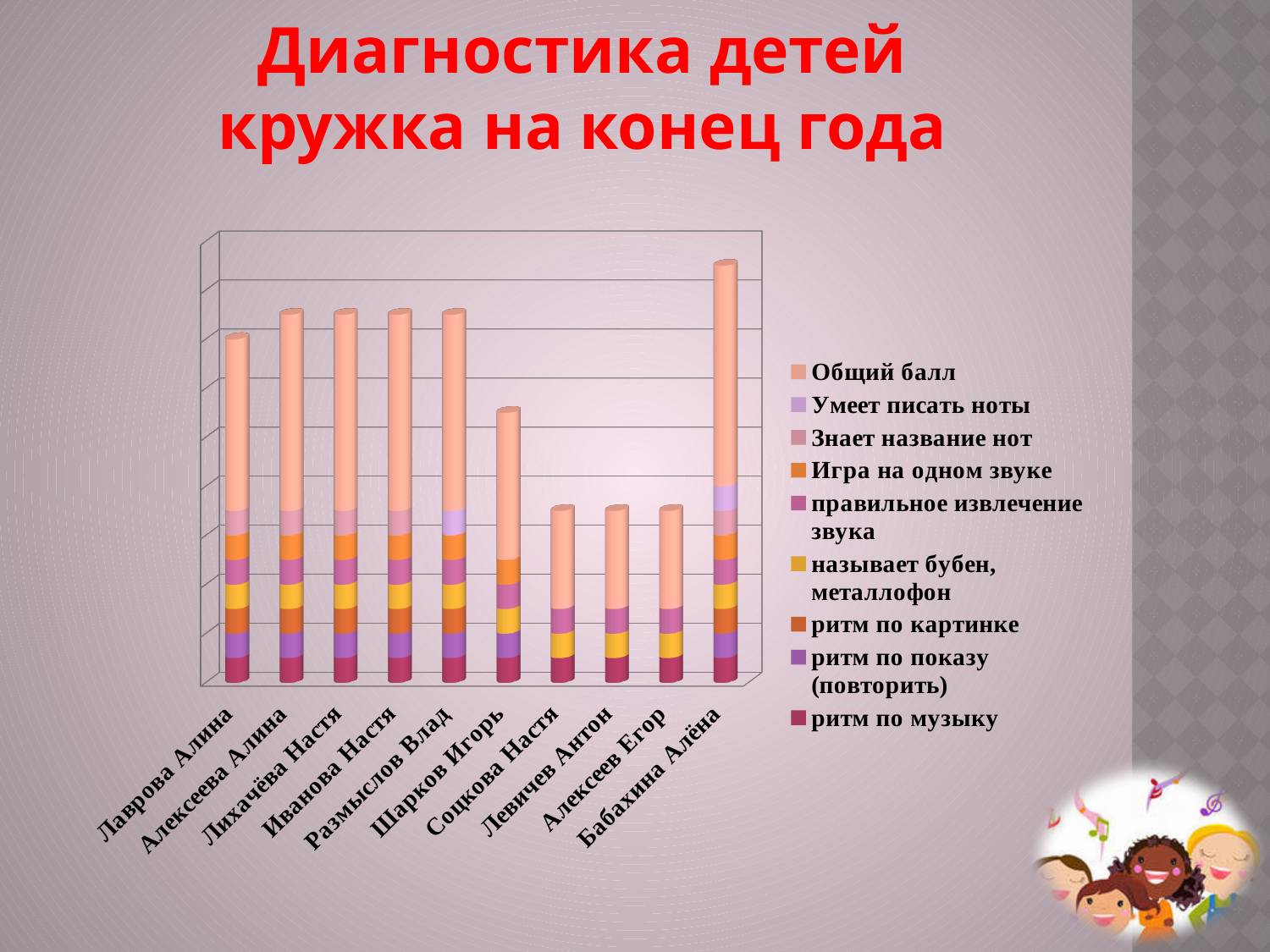
Which child has the tallest stacked bar in the chart? Бабахина Алёна Which bar is taller: Шарков Игорь or Соцкова Настя? Шарков Игорь Which bar is taller: Размыслов Влад or Левичев Антон? Размыслов Влад How many children (categories) are shown along the x axis of the chart? 10 What kind of chart is shown on the slide? Stacked bar chart How many series does the chart's legend list? 9 Which legend entry corresponds to the bottom segment of each stacked bar? ритм по музыку Which bar is taller: Лаврова Алина or Алексеева Алина? Алексеева Алина What is the first entry listed in the chart's legend? Общий балл